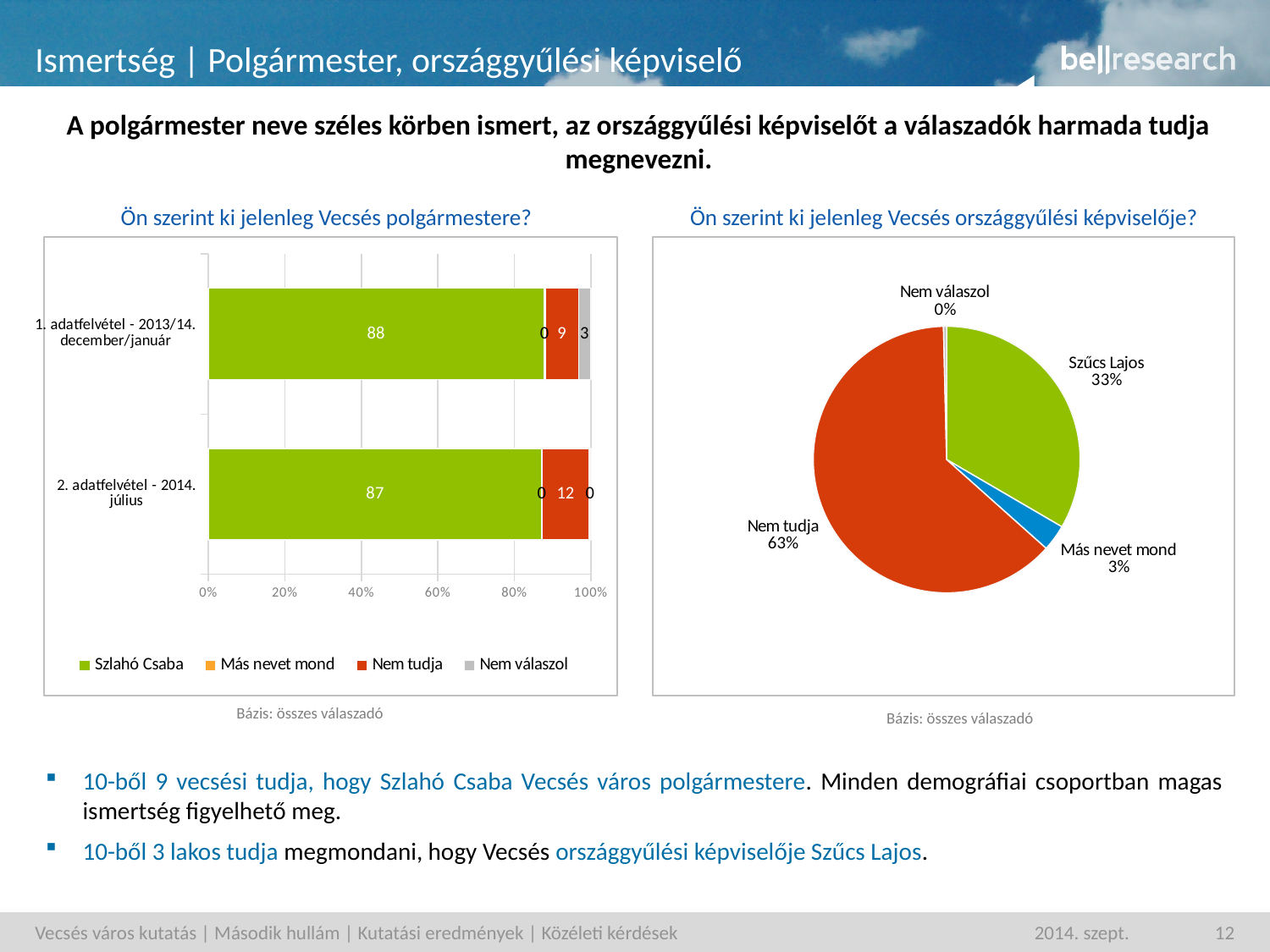
In the chart 'Ön szerint ki jelenleg Vecsés polgármestere?', what is the value for Nem válaszol in the 1. adatfelvétel - 2013/14. december/január bar? 3 In the chart 'Ön szerint ki jelenleg Vecsés polgármestere?', which data collection has the higher Szlahó Csaba value? 1. adatfelvétel - 2013/14. december/január What kind of chart is 'Ön szerint ki jelenleg Vecsés országgyűlési képviselője?' Pie chart In the chart 'Ön szerint ki jelenleg Vecsés polgármestere?', what is the value for Nem tudja in the 2. adatfelvétel - 2014. július bar? 12 In the chart 'Ön szerint ki jelenleg Vecsés polgármestere?', how many series does the legend list? 4 In the pie chart 'Ön szerint ki jelenleg Vecsés országgyűlési képviselője?', what is the difference between the Nem tudja and Szűcs Lajos shares? 30% In the pie chart 'Ön szerint ki jelenleg Vecsés országgyűlési képviselője?', which slice is the largest? Nem tudja In the chart 'Ön szerint ki jelenleg Vecsés polgármestere?', how many bars (data collections) are shown? 2 What kind of chart is 'Ön szerint ki jelenleg Vecsés polgármestere?' Stacked bar chart In the pie chart 'Ön szerint ki jelenleg Vecsés országgyűlési képviselője?', what share does Szűcs Lajos have? 33% In the chart 'Ön szerint ki jelenleg Vecsés polgármestere?', what is the difference between the Nem tudja values of the two data collections? 3 In the chart 'Ön szerint ki jelenleg Vecsés polgármestere?', what is the value for Szlahó Csaba in the 1. adatfelvétel - 2013/14. december/január bar? 88